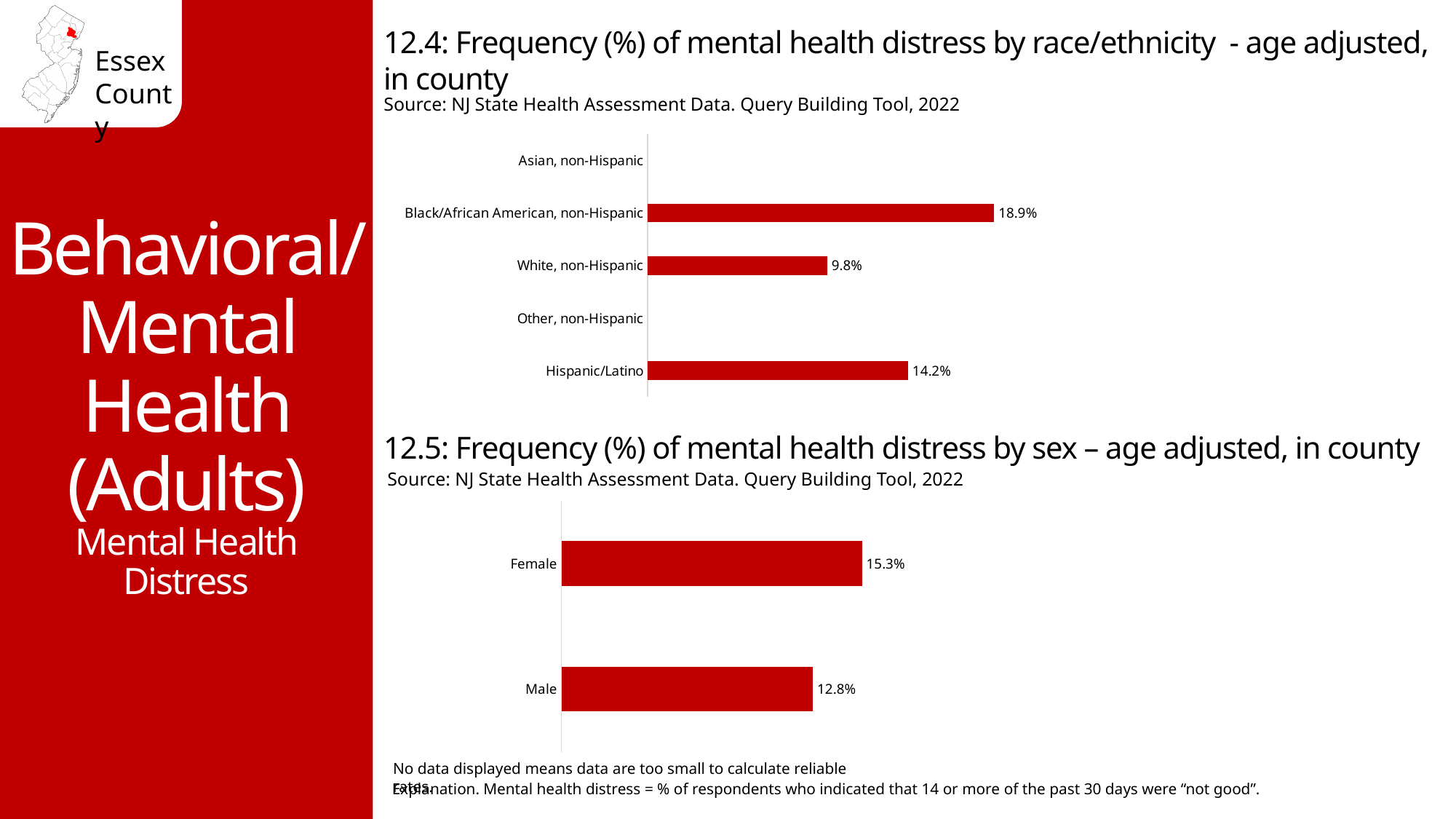
In the chart '12.4: Frequency (%) of mental health distress by race/ethnicity - age adjusted, in county', how many categories are listed on the axis? 5 In the chart '12.5: Frequency (%) of mental health distress by sex – age adjusted, in county', what is the value for Male? 12.8% In the chart '12.5: Frequency (%) of mental health distress by sex – age adjusted, in county', which is larger, Female or Male? Female What kind of chart is '12.5: Frequency (%) of mental health distress by sex – age adjusted, in county'? Bar chart In the chart '12.5: Frequency (%) of mental health distress by sex – age adjusted, in county', what is the value for Female? 15.3% In the chart '12.4: Frequency (%) of mental health distress by race/ethnicity - age adjusted, in county', which categories have no bar displayed? Asian, non-Hispanic and Other, non-Hispanic In the chart '12.5: Frequency (%) of mental health distress by sex – age adjusted, in county', what is the difference between the Female and Male values? 2.5% In the chart '12.4: Frequency (%) of mental health distress by race/ethnicity - age adjusted, in county', what is the value for White, non-Hispanic? 9.8% In the chart '12.4: Frequency (%) of mental health distress by race/ethnicity - age adjusted, in county', what is the value for Hispanic/Latino? 14.2% In the chart '12.4: Frequency (%) of mental health distress by race/ethnicity - age adjusted, in county', what is the value for Black/African American, non-Hispanic? 18.9% In the chart '12.4: Frequency (%) of mental health distress by race/ethnicity - age adjusted, in county', what is the difference between the values for Black/African American, non-Hispanic and White, non-Hispanic? 9.1% In the chart '12.4: Frequency (%) of mental health distress by race/ethnicity - age adjusted, in county', which category has the highest value? Black/African American, non-Hispanic